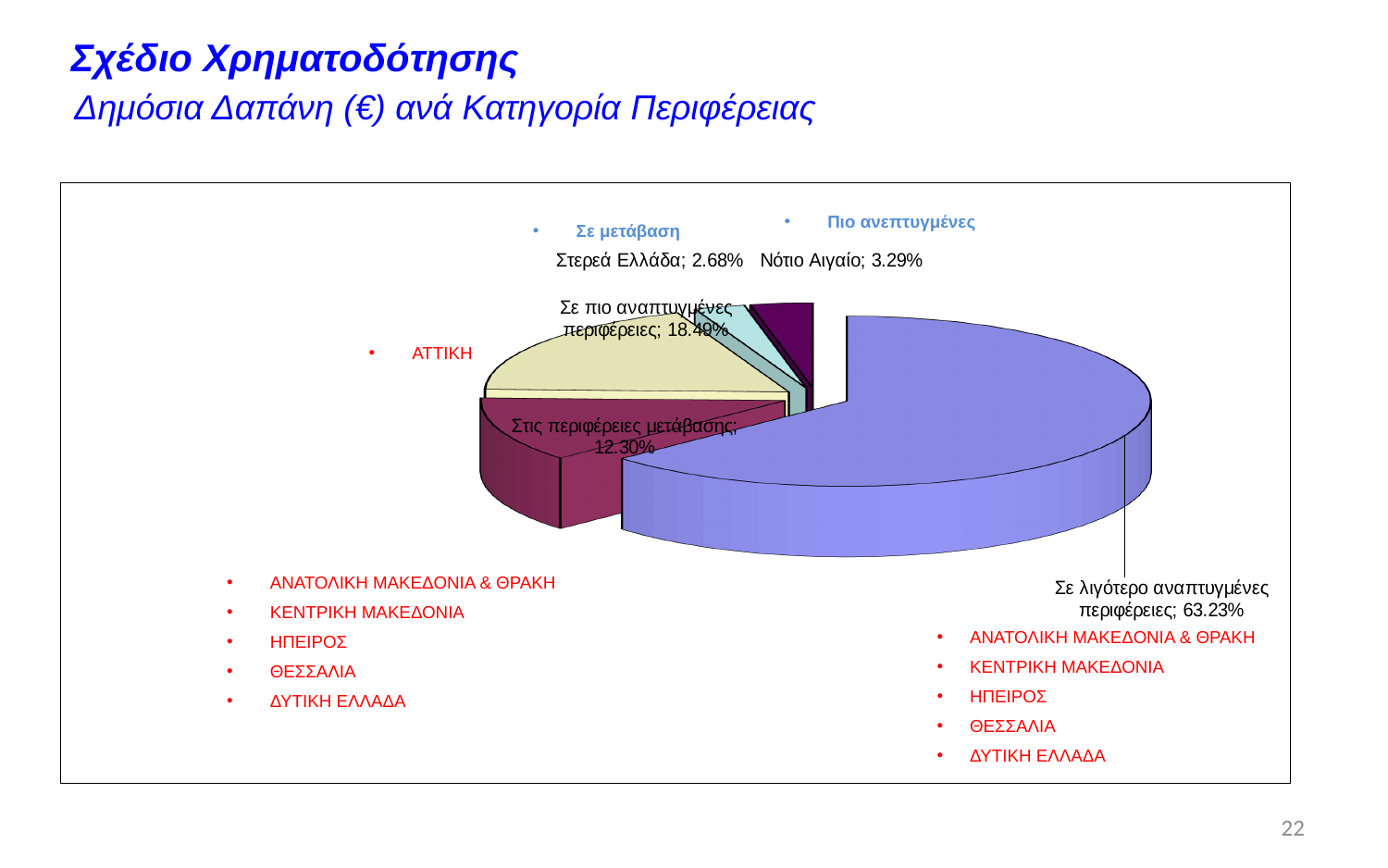
What percentage is shown for 'Στερεά Ελλάδα'? 2.68% What is the difference in percentage points between 'Νότιο Αιγαίο' and 'Στερεά Ελλάδα'? 0.61 percentage points How many slices does the pie chart have? 5 What percentage is shown for 'Σε λιγότερο αναπτυγμένες περιφέρειες'? 63.23% What percentage is shown for 'Στις περιφέρειες μετάβασης'? 12.30% Which has the larger share, 'Σε πιο αναπτυγμένες περιφέρειες' or 'Στις περιφέρειες μετάβασης'? Σε πιο αναπτυγμένες περιφέρειες Which slice of the pie chart is the smallest? Στερεά Ελλάδα Which has the larger share, 'Νότιο Αιγαίο' or 'Στερεά Ελλάδα'? Νότιο Αιγαίο What percentage is shown for 'Νότιο Αιγαίο'? 3.29% Which slice of the pie chart is the largest? Σε λιγότερο αναπτυγμένες περιφέρειες What is the difference in percentage points between 'Σε λιγότερο αναπτυγμένες περιφέρειες' and 'Στις περιφέρειες μετάβασης'? 50.93 percentage points What kind of chart is shown on the slide? Pie chart